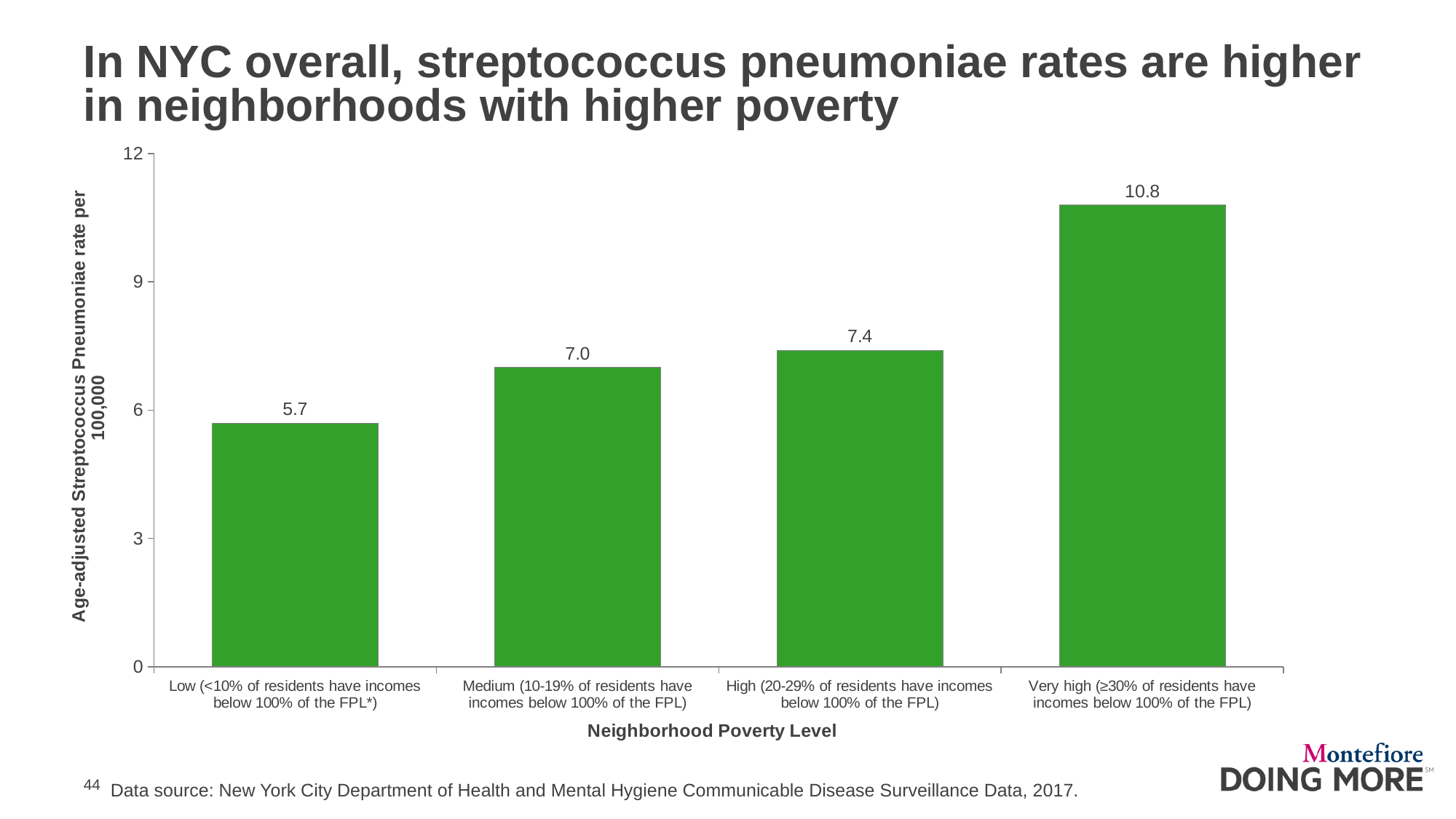
What is the difference between the Streptococcus pneumoniae rate for the Very high and Low poverty levels? 5.1 Is the Streptococcus pneumoniae rate for the High poverty level greater or less than 9? less Which has a higher Streptococcus pneumoniae rate, the Medium or the Very high poverty level? Very high How many neighborhood poverty levels are shown on the chart? 4 Which neighborhood poverty level has the lowest Streptococcus pneumoniae rate? Low What is the age-adjusted Streptococcus pneumoniae rate per 100,000 for the High neighborhood poverty level? 7.4 Which neighborhood poverty level has the highest Streptococcus pneumoniae rate? Very high Do the Streptococcus pneumoniae rates rise or fall as neighborhood poverty level increases from Low to Very high? Rise What kind of chart is shown on the slide? Bar chart What is the age-adjusted Streptococcus pneumoniae rate per 100,000 for the Medium neighborhood poverty level? 7.0 What is the age-adjusted Streptococcus pneumoniae rate per 100,000 for the Very high neighborhood poverty level? 10.8 What is the age-adjusted Streptococcus pneumoniae rate per 100,000 for the Low neighborhood poverty level? 5.7